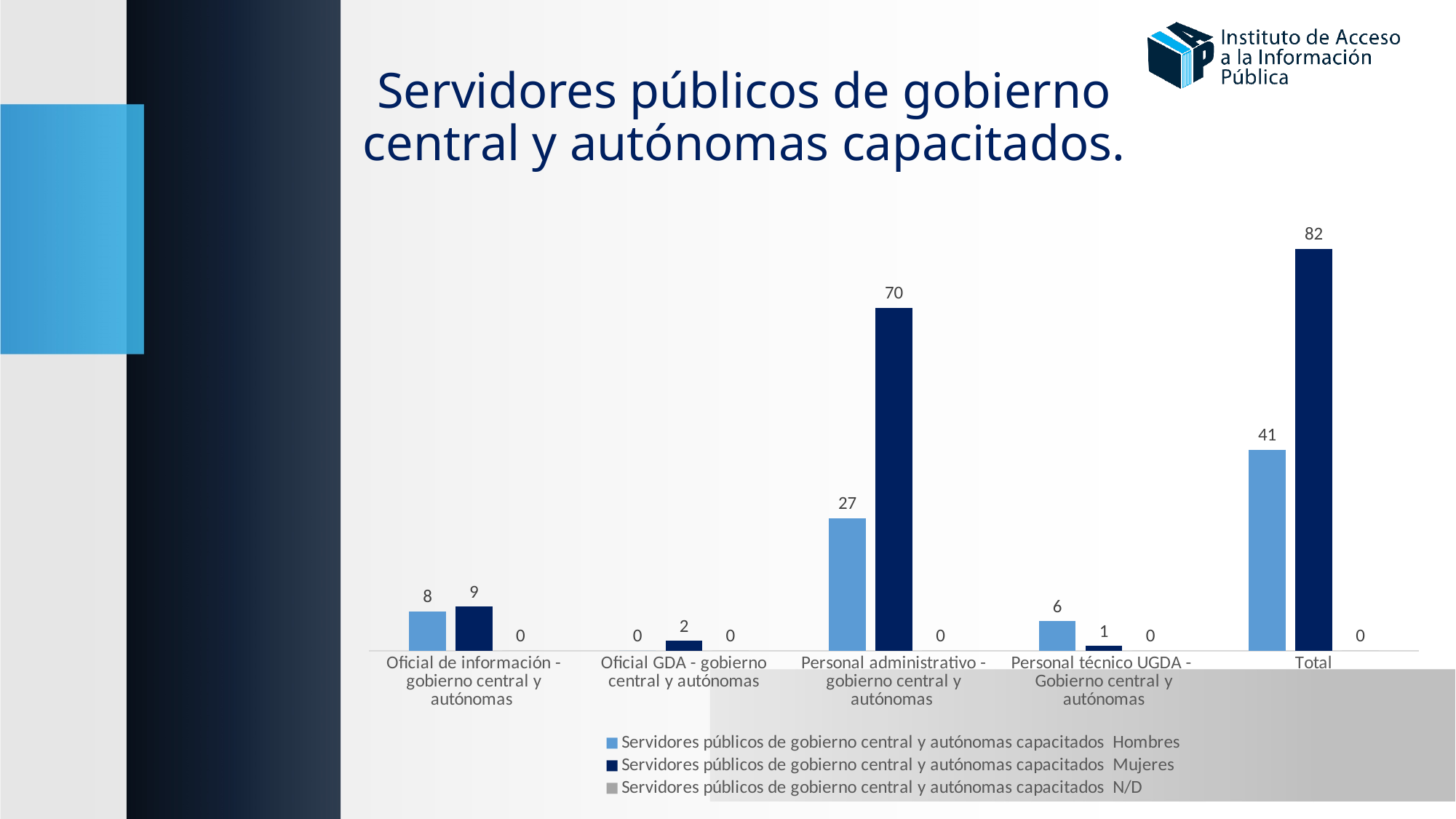
What is the value for Mujeres in the Oficial GDA - gobierno central y autónomas category? 2 What is the value for Hombres in the Total category? 41 How many series does the legend list? 3 Excluding Total, which category has the lowest Mujeres value? Personal técnico UGDA - Gobierno central y autónomas What is the value for Mujeres in the Personal administrativo - gobierno central y autónomas category? 70 What kind of chart is shown on the slide? Bar chart Which is larger in the Personal técnico UGDA - Gobierno central y autónomas category, Hombres or Mujeres? Hombres What is the value for N/D in the Personal administrativo - gobierno central y autónomas category? 0 What is the difference between the Mujeres and Hombres values in the Total category? 41 How many categories are shown on the x axis? 5 What is the value for Hombres in the Oficial de información - gobierno central y autónomas category? 8 Which category has the highest Hombres value? Total